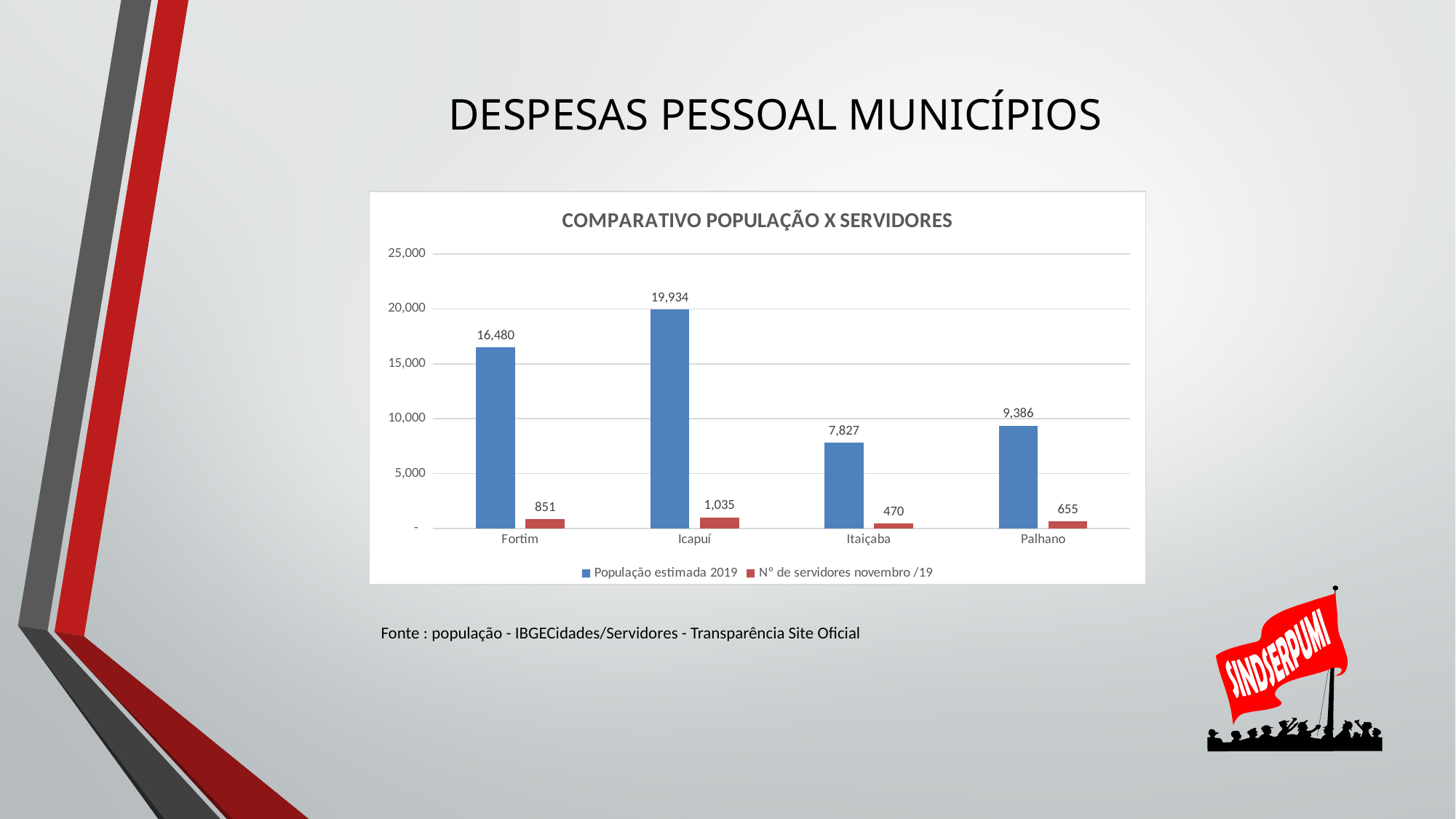
What is the 'Nº de servidores novembro /19' value for Itaiçaba? 470 Which has more 'Nº de servidores novembro /19', Fortim or Palhano? Fortim Which municipality has the highest 'População estimada 2019'? Icapuí What kind of chart is shown? bar chart What is the difference between the 'População estimada 2019' values for Icapuí and Fortim? 3,454 What is the title of the chart? COMPARATIVO POPULAÇÃO X SERVIDORES How many series does the legend list? 2 What is the 'População estimada 2019' value for Palhano? 9,386 Which municipality has the lowest 'Nº de servidores novembro /19'? Itaiçaba How many municipalities are shown on the x axis? 4 What is the 'População estimada 2019' value for Icapuí? 19,934 Is the 'População estimada 2019' value for Itaiçaba greater or less than 10,000? less